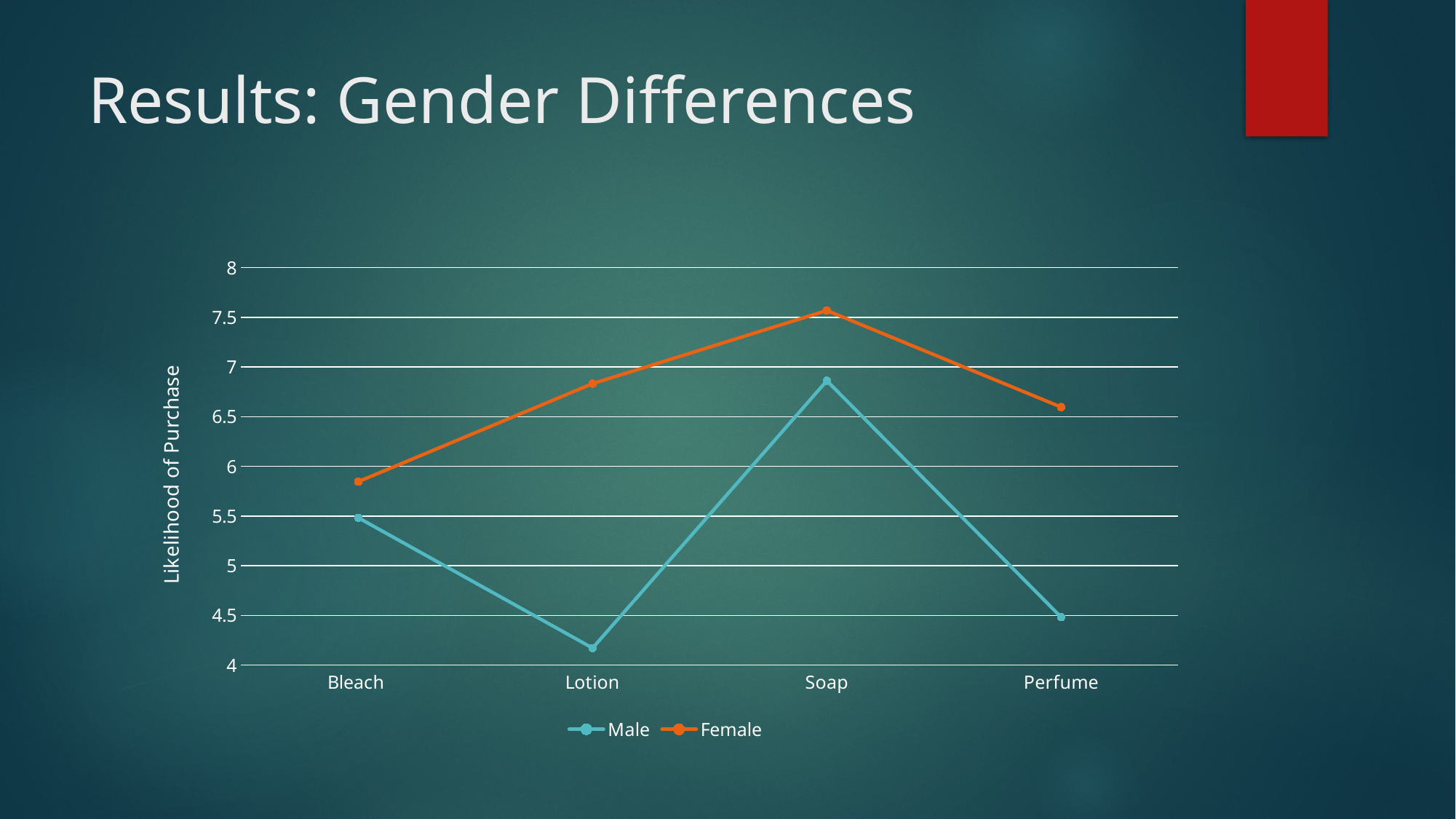
For Lotion, which series has the larger value, Male or Female? Female For which product is the Male likelihood of purchase highest? Soap How many series does the legend list? 2 What kind of chart is shown on the slide? line chart Is the Male value for Lotion greater or less than 4.5? less Does the Female line rise or fall from Bleach to Soap? rise Is the Male value for Perfume greater or less than 5? less For which product is the Female likelihood of purchase lowest? Bleach How many product categories are shown on the x axis? 4 For which product is the Female likelihood of purchase highest? Soap For which product is the Male likelihood of purchase lowest? Lotion